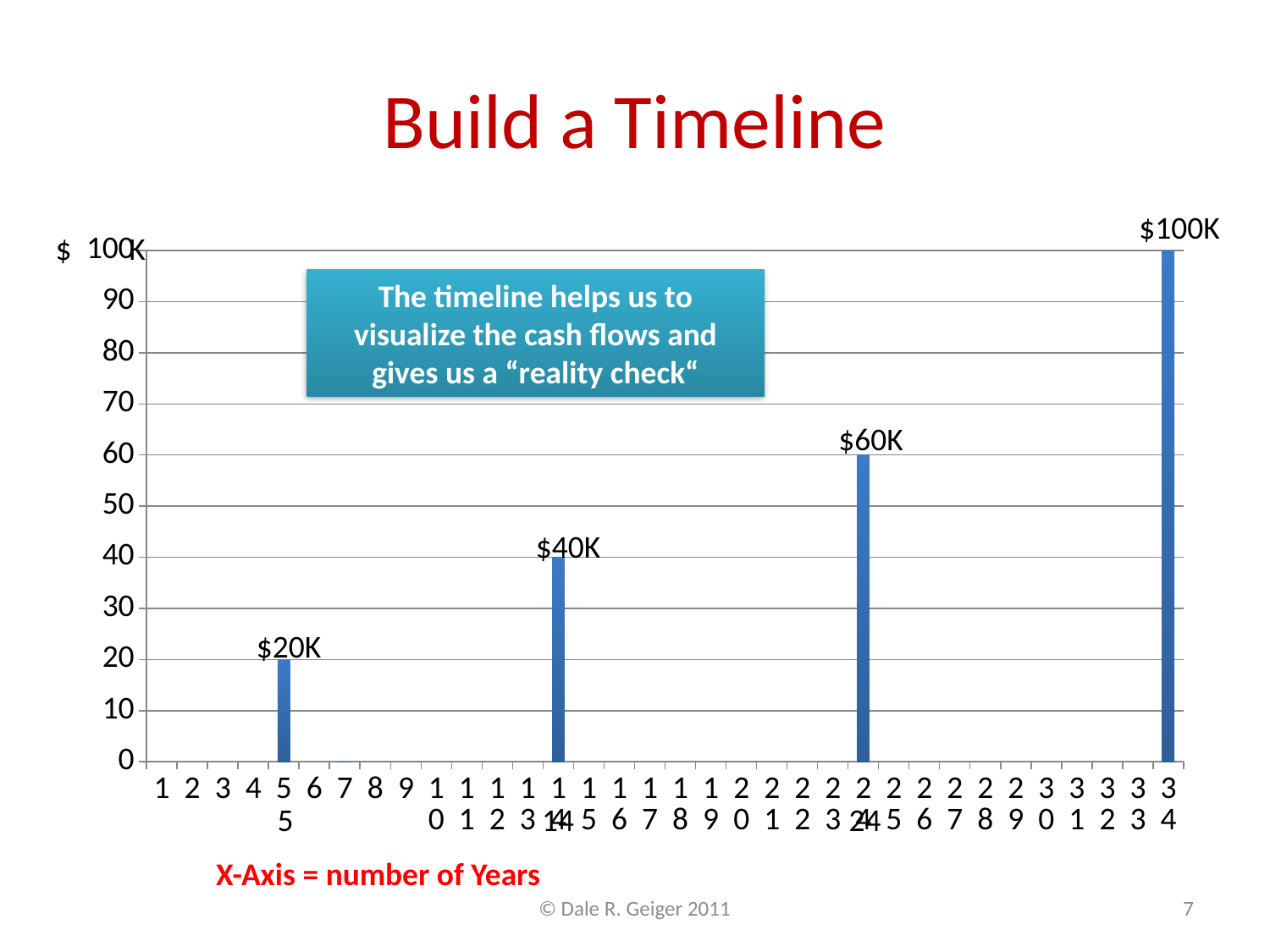
What is the difference between the bar at year 34 and the bar at year 24? $40K What is the difference between the bar at year 14 and the bar at year 5? $20K What kind of chart is shown on the slide? bar chart What is the value of the bar at year 5? $20K What is the value of the bar at year 24? $60K What is the value of the bar at year 14? $40K Which is larger, the bar at year 24 or the bar at year 14? year 24 According to the red note below the chart, what does the x axis represent? number of Years What is the value of the bar at year 34? $100K Do the labelled bar values rise or fall as the years increase along the x axis? rise Which year has the lowest labelled cash flow bar? 5 Which year has the highest cash flow bar? 34